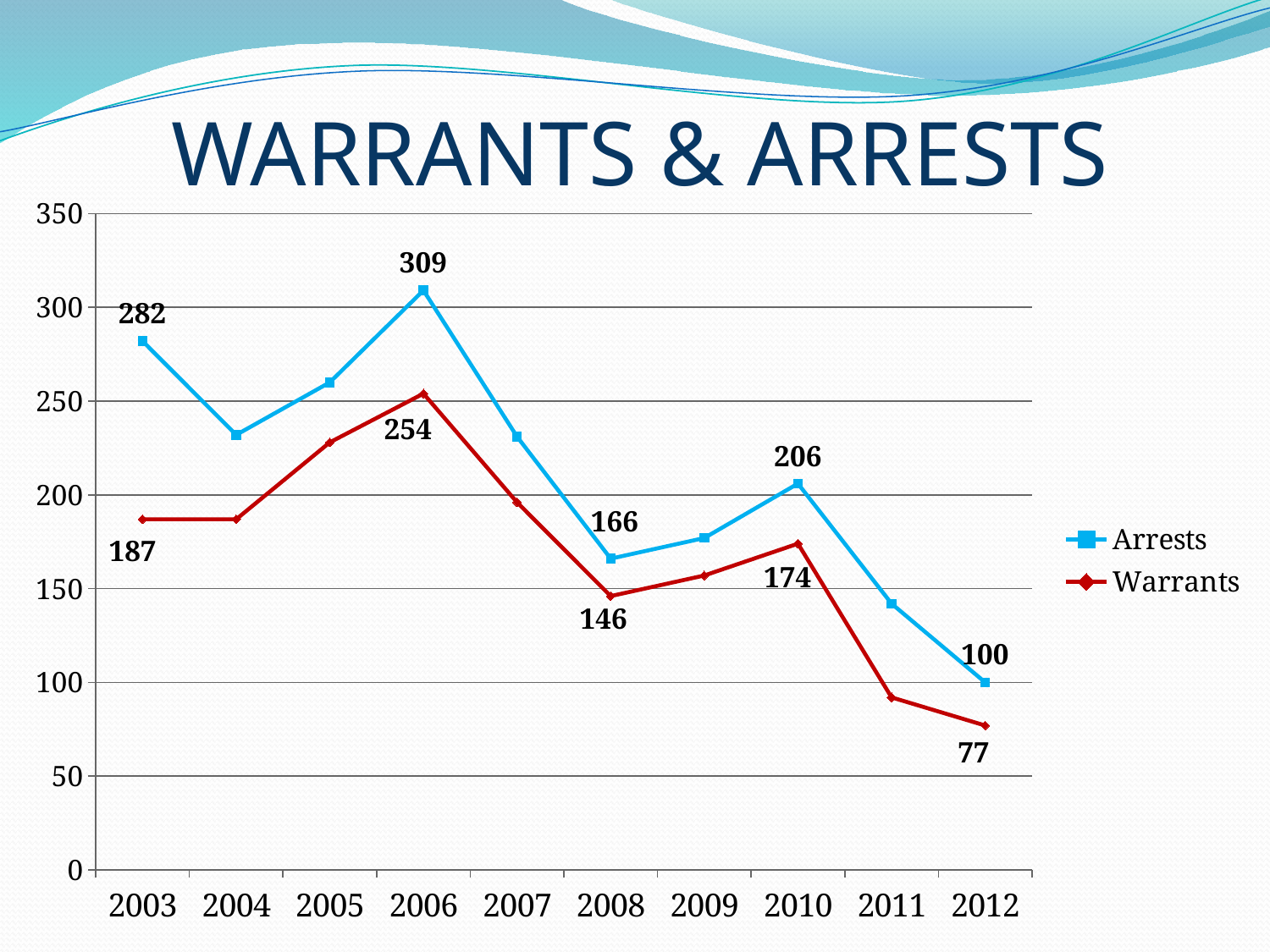
In which year is the Arrests series highest? 2006 How many years are shown on the x axis? 10 Which is larger, Arrests in 2003 or Arrests in 2010? Arrests in 2003 Is the value for Warrants in 2011 greater or less than 100? less What is the value for Warrants in 2012? 77 How many series does the legend list? 2 What is the value for Warrants in 2003? 187 Is the value for Arrests in 2005 greater or less than 250? greater What is the value for Arrests in 2006? 309 In which year is the Warrants series lowest? 2012 What is the difference between Arrests and Warrants in 2012? 23 What is the difference between Arrests and Warrants in 2006? 55